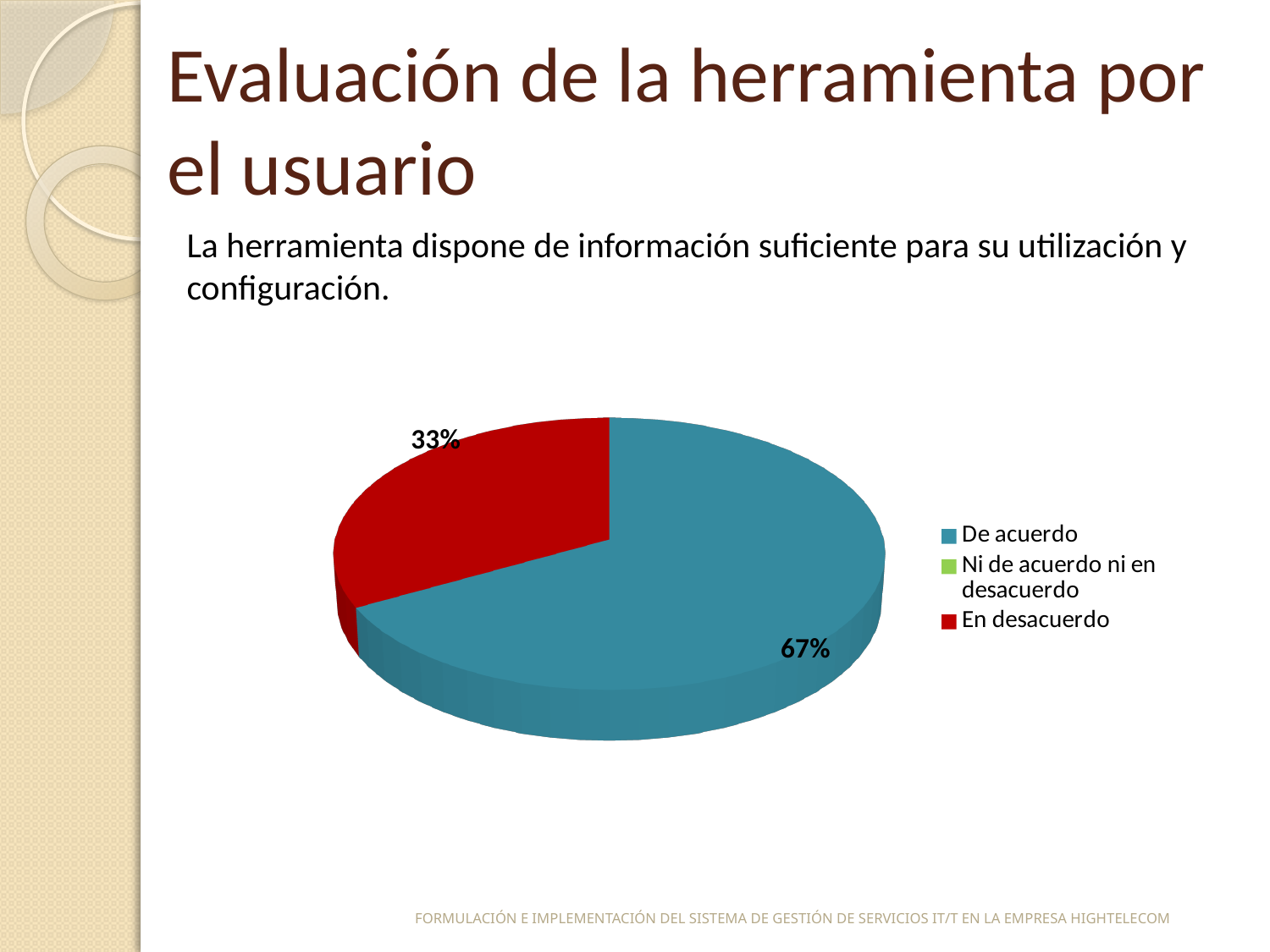
What is the difference in percentage points between the "De acuerdo" slice and the "En desacuerdo" slice? 34 percentage points Which category has the largest share of the pie? De acuerdo What colour is the "En desacuerdo" slice? Red Which of the two labelled slices is larger, "De acuerdo" or "En desacuerdo"? De acuerdo What percentage of the pie corresponds to "En desacuerdo"? 33% What colour is the "De acuerdo" slice? Blue How many entries does the legend list? 3 What percentage of the pie corresponds to "De acuerdo"? 67% How many slices of the pie have a visible data label? 2 What type of chart is shown on the slide? Pie chart Which legend entry does not have a visible slice in the pie? Ni de acuerdo ni en desacuerdo